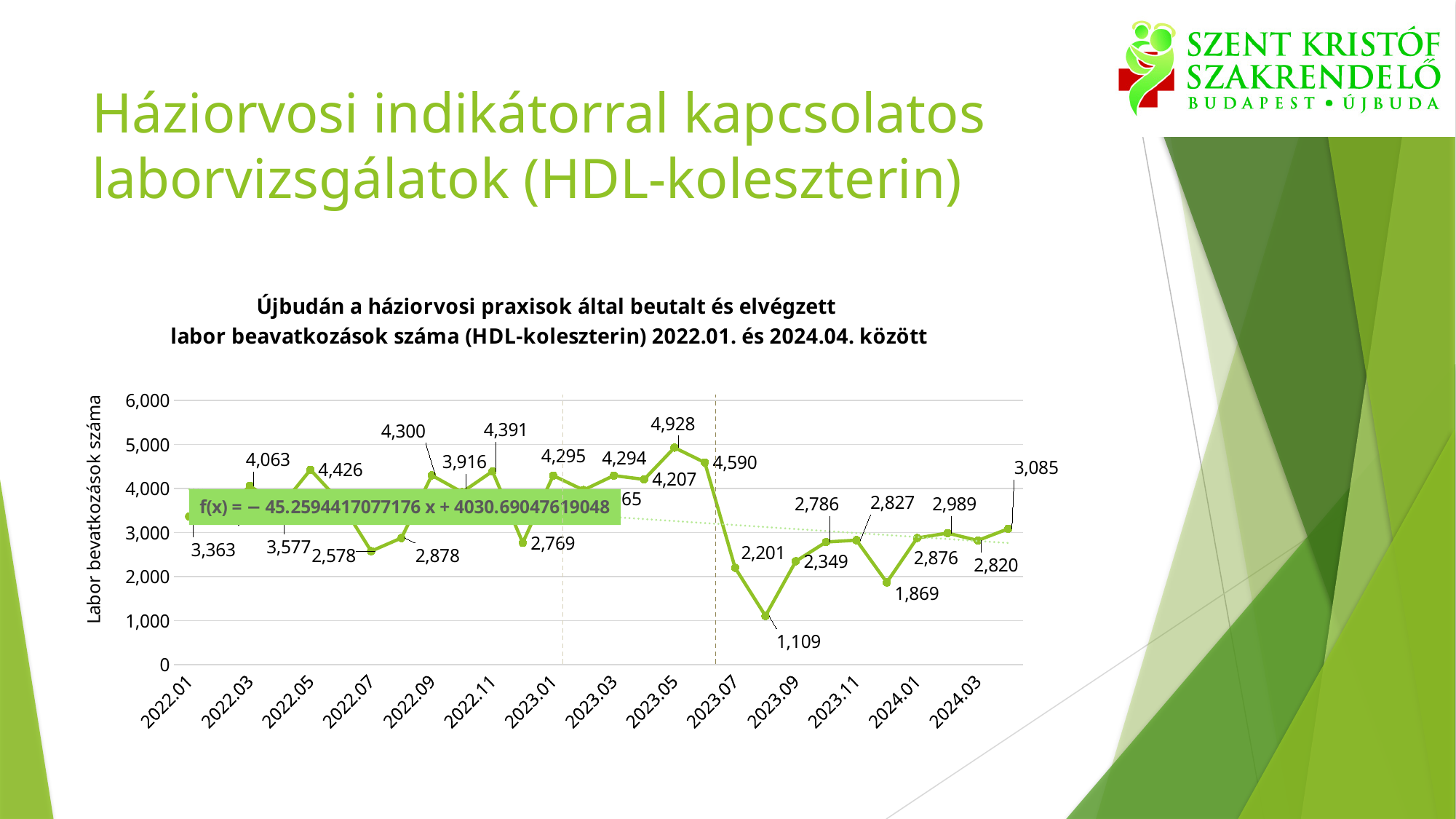
What is the value of the last point on the chart? 3,085 What is the highest value plotted on the chart? 4,928 What is the difference between the first point (3,363) and the last point (3,085) on the chart? 278 What is the difference between the highest value (4,928) and the lowest value (1,109) on the chart? 3,819 How many plotted points have a value below 2,000? 2 Is the value for 2022.01 greater or less than 3,000? greater What is the lowest value plotted on the chart? 1,109 Which is larger, the first point on the chart (2022.01) or the last point? the first point (3,363) What type of chart is shown on the slide? line chart What is the value for 2022.01, the first point on the chart? 3,363 According to the dotted trend line, do the values overall rise or fall from 2022.01 to 2024.04? fall What is the label of the vertical axis of the chart? Labor beavatkozások száma